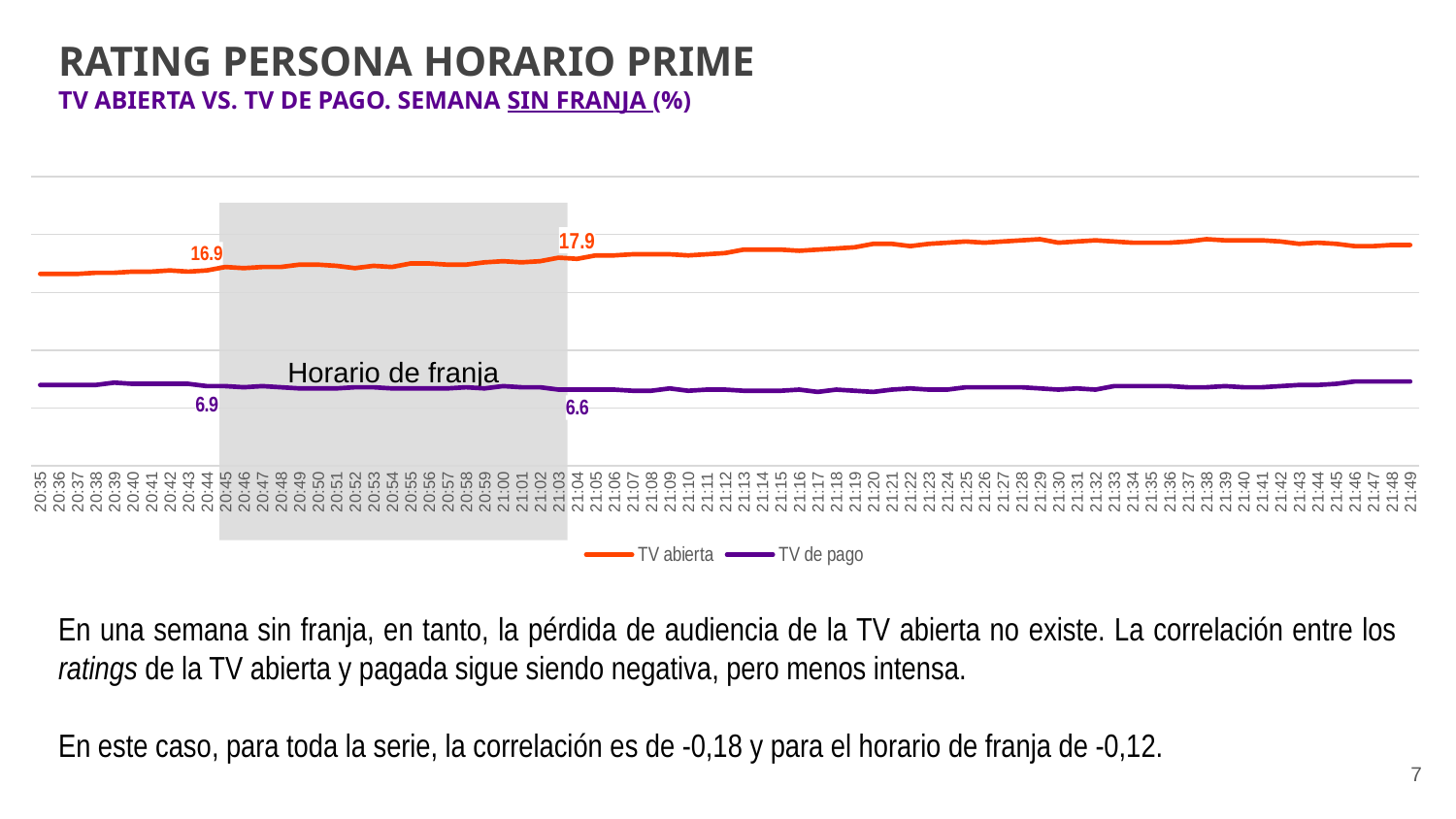
What is the value of TV de pago at 21:03? 6.6 What is the value of TV de pago at 20:45? 6.9 How many series does the legend list? 2 Is the TV de pago value at 21:03 higher or lower than at 20:45? lower What label is shown on the shaded area of the chart? Horario de franja Which series has the higher values throughout the chart, TV abierta or TV de pago? TV abierta Does the TV abierta line generally rise or fall from 20:35 to 21:49? rise What type of chart is shown on the slide? line chart